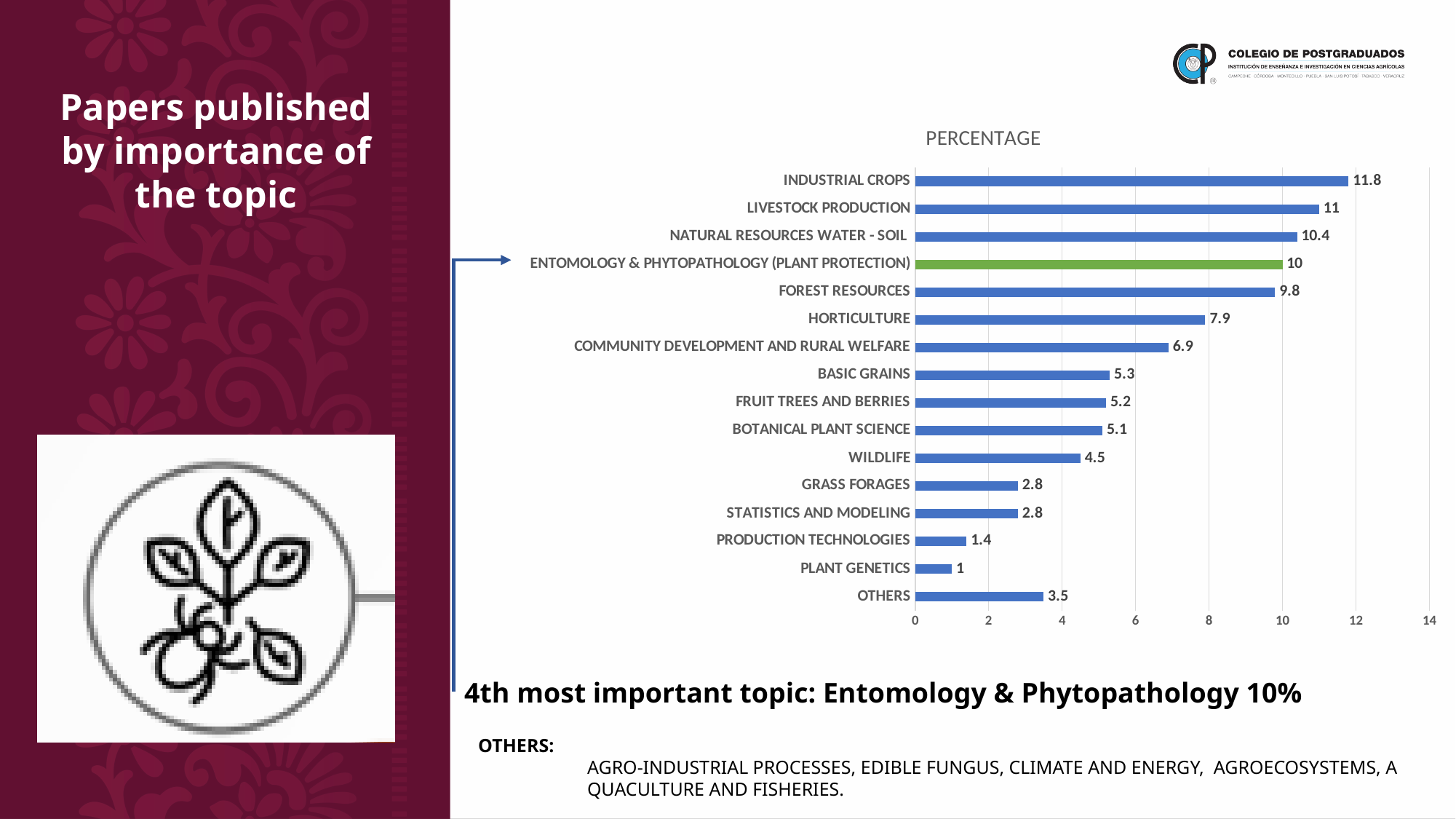
What kind of chart is shown on the slide? bar chart What is the value for INDUSTRIAL CROPS? 11.8 How many categories are shown in the chart? 16 What is the difference between the values for LIVESTOCK PRODUCTION and FOREST RESOURCES? 1.2 What is the value for WILDLIFE? 4.5 What is the value for ENTOMOLOGY & PHYTOPATHOLOGY (PLANT PROTECTION)? 10 Is the value for NATURAL RESOURCES WATER - SOIL greater or less than 8? greater Which is larger, the value for HORTICULTURE or the value for COMMUNITY DEVELOPMENT AND RURAL WELFARE? HORTICULTURE Which category's bar is coloured green instead of blue? ENTOMOLOGY & PHYTOPATHOLOGY (PLANT PROTECTION) Which category has the lowest value? PLANT GENETICS What is the title of the chart? PERCENTAGE Which category has the highest value? INDUSTRIAL CROPS